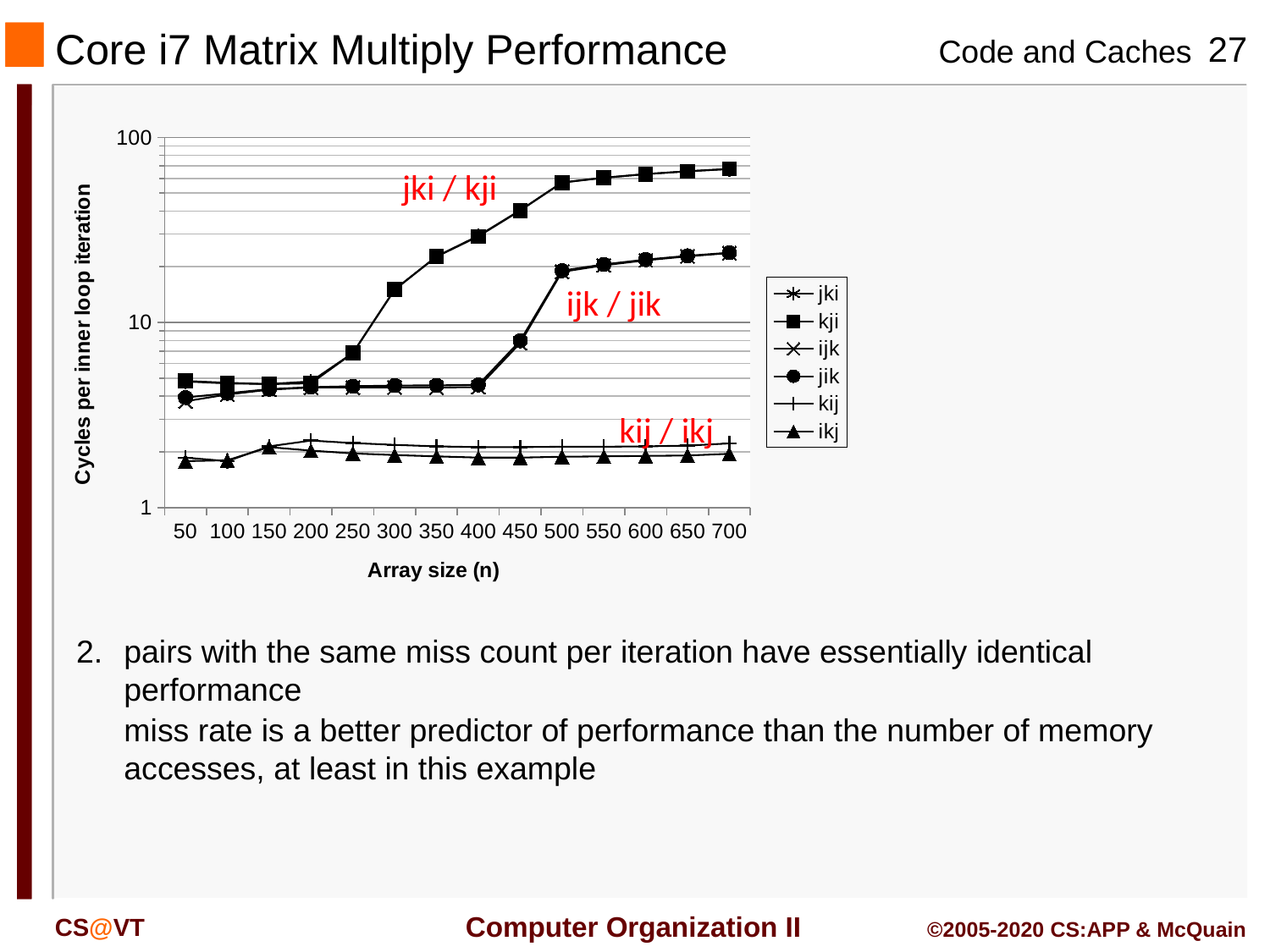
How many series does the legend list? 6 Do the values for the kji series rise or fall as the array size increases? rise At array size 700, which is larger: the value for kji or the value for jik? kji How many array sizes are plotted along the x axis? 14 Is the value for the jik series at array size 300 greater or less than 10? less What is the label of the x axis? Array size (n) Is the value for the kji series at array size 50 greater or less than 10? less What is the label of the y axis? Cycles per inner loop iteration Is the value for the ikj series at array size 700 greater or less than 10? less What kind of chart is shown on the slide? line chart